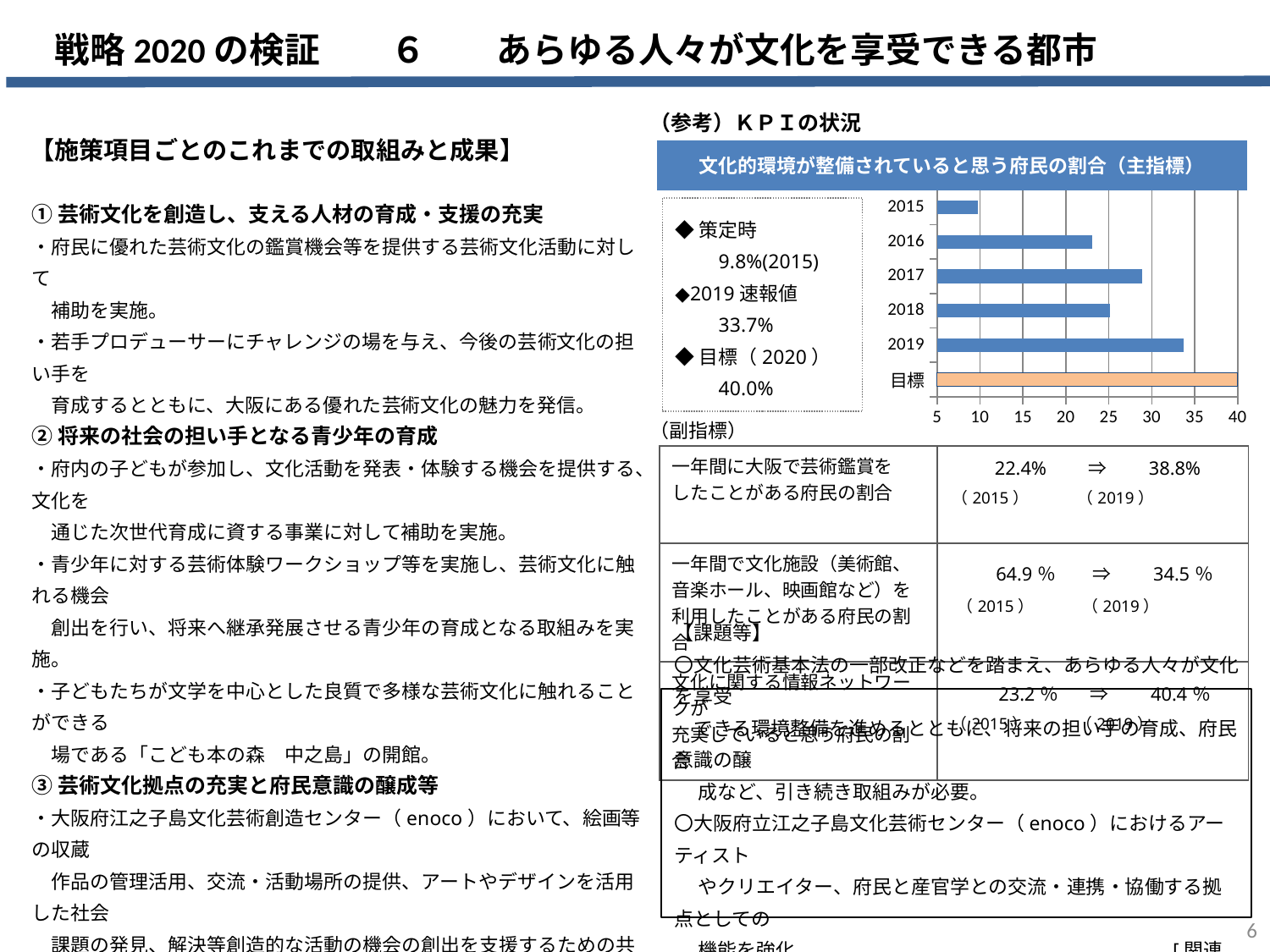
In the chart 文化的環境が整備されていると思う府民の割合（主指標）, which is larger, the value for 2017 or the value for 2016? 2017 Which category has the longest bar in the chart 文化的環境が整備されていると思う府民の割合（主指標）? 目標 Which category has the shortest bar in the chart 文化的環境が整備されていると思う府民の割合（主指標）? 2015 In the chart 文化的環境が整備されていると思う府民の割合（主指標）, is the value for 2016 greater or less than 20? greater In the chart 文化的環境が整備されていると思う府民の割合（主指標）, do the values rise or fall from 2015 to 2017? rise In the chart 文化的環境が整備されていると思う府民の割合（主指標）, is the value for 2018 greater or less than 30? less In the chart 文化的環境が整備されていると思う府民の割合（主指標）, which is larger, the value for 2019 or the value for 2018? 2019 What kind of chart is shown under the heading 文化的環境が整備されていると思う府民の割合（主指標）? bar chart In the chart 文化的環境が整備されていると思う府民の割合（主指標）, is the value for 2017 greater or less than 30? less How many categories are plotted on the bar chart 文化的環境が整備されていると思う府民の割合（主指標）? 6 What is the title of the bar chart on the slide? 文化的環境が整備されていると思う府民の割合（主指標）